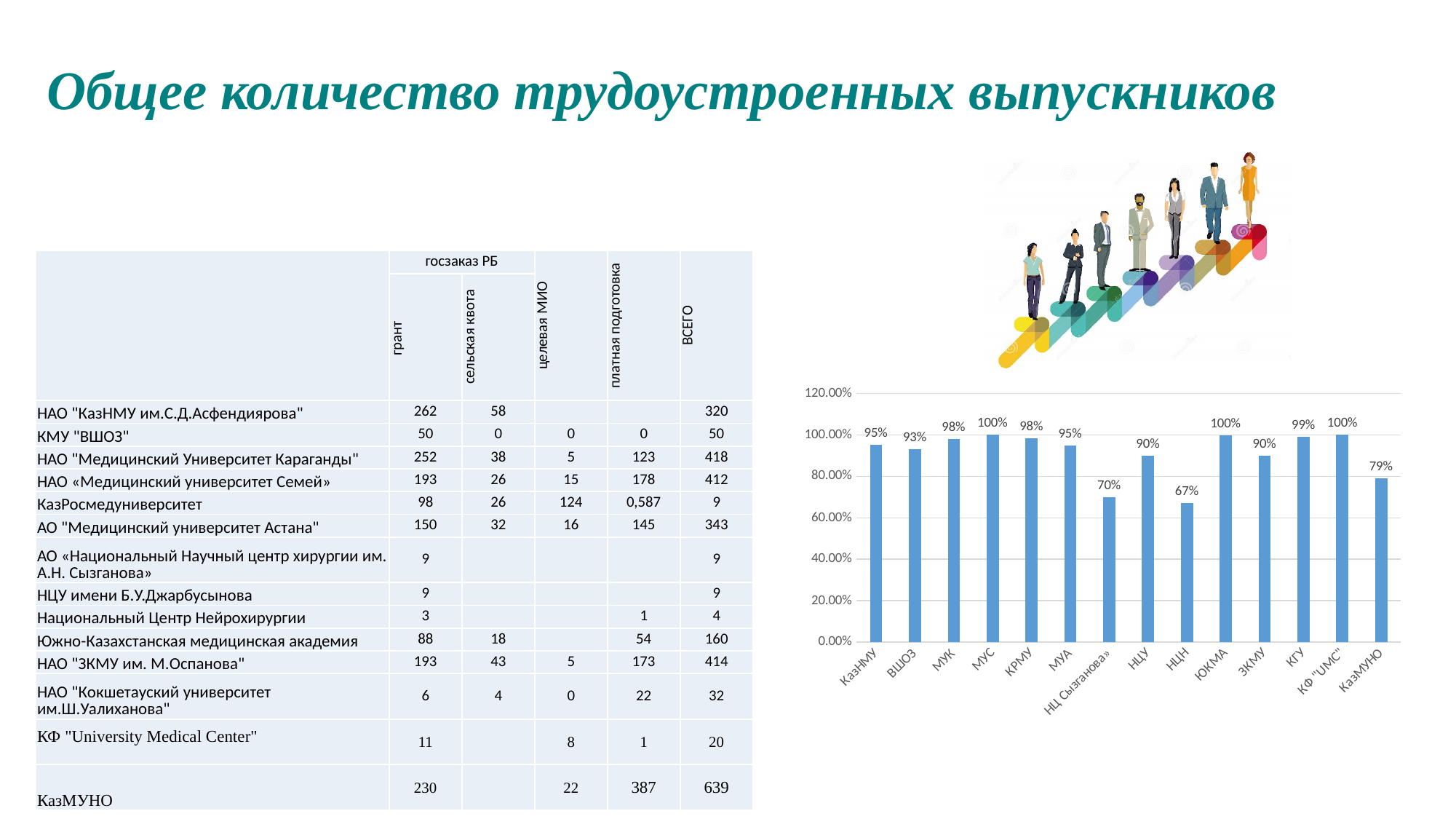
What kind of chart is shown on the right side of the slide? bar chart In the bar chart, is the value for НЦУ greater or less than 80%? greater What is the highest tick value shown on the y axis of the bar chart? 120.00% In the bar chart, what is the value for КазМУНО? 79% In the bar chart, what is the difference between the values for МУК and ВШОЗ? 5% In the bar chart, which is larger, the value for КГУ or the value for ЗКМУ? КГУ In the bar chart, what is the value for КазНМУ? 95% In the bar chart, what is the value for НЦН? 67% In the bar chart, what is the difference between the values for МУС and КазМУНО? 21% In the bar chart, what is the value for НЦ Сызганова? 70% In the bar chart, which category has the lowest value? НЦН How many categories are shown on the x axis of the bar chart? 14